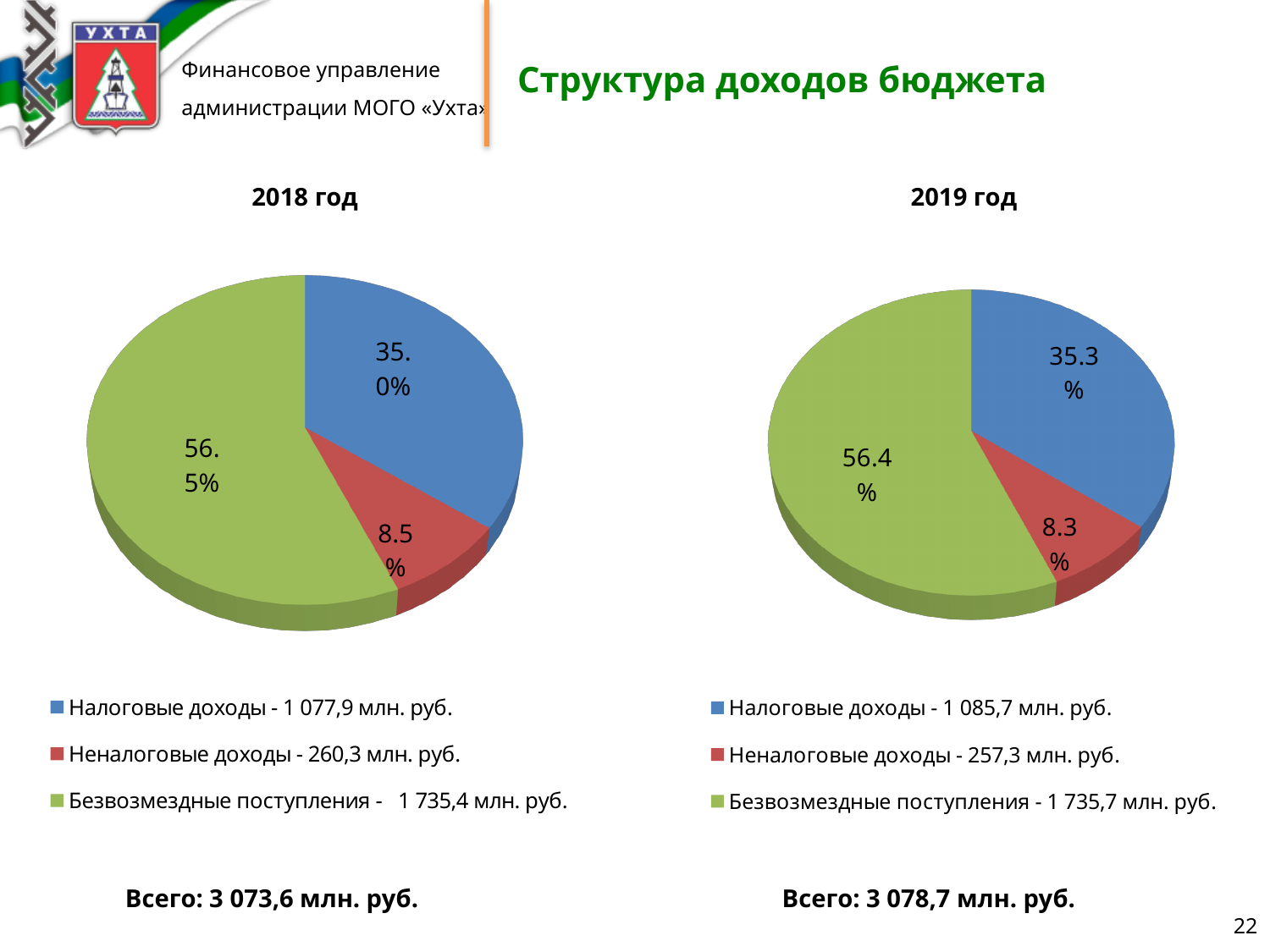
In the 2018 год chart, which category has the smallest share? Неналоговые доходы In the 2019 год chart, what percentage is shown for Неналоговые доходы? 8.3% In the 2019 год chart, which category has the largest share? Безвозмездные поступления What colour represents Безвозмездные поступления in the 2018 год chart? Green In the 2019 год chart legend, what amount is given for Налоговые доходы? 1 085,7 млн. руб. In the 2018 год chart, what percentage is shown for Неналоговые доходы? 8.5% In the 2018 год chart, what share of the pie is Налоговые доходы? 35.0% In the 2019 год chart, which is larger: the share of Налоговые доходы or the share of Неналоговые доходы? Налоговые доходы What type of chart is used for 2019 год? Pie chart How many slices does the 2018 год pie chart have? 3 In the 2018 год chart, what is the difference in percentage points between Безвозмездные поступления and Налоговые доходы? 21.5 In the 2019 год chart, what share of the pie is Безвозмездные поступления? 56.4%